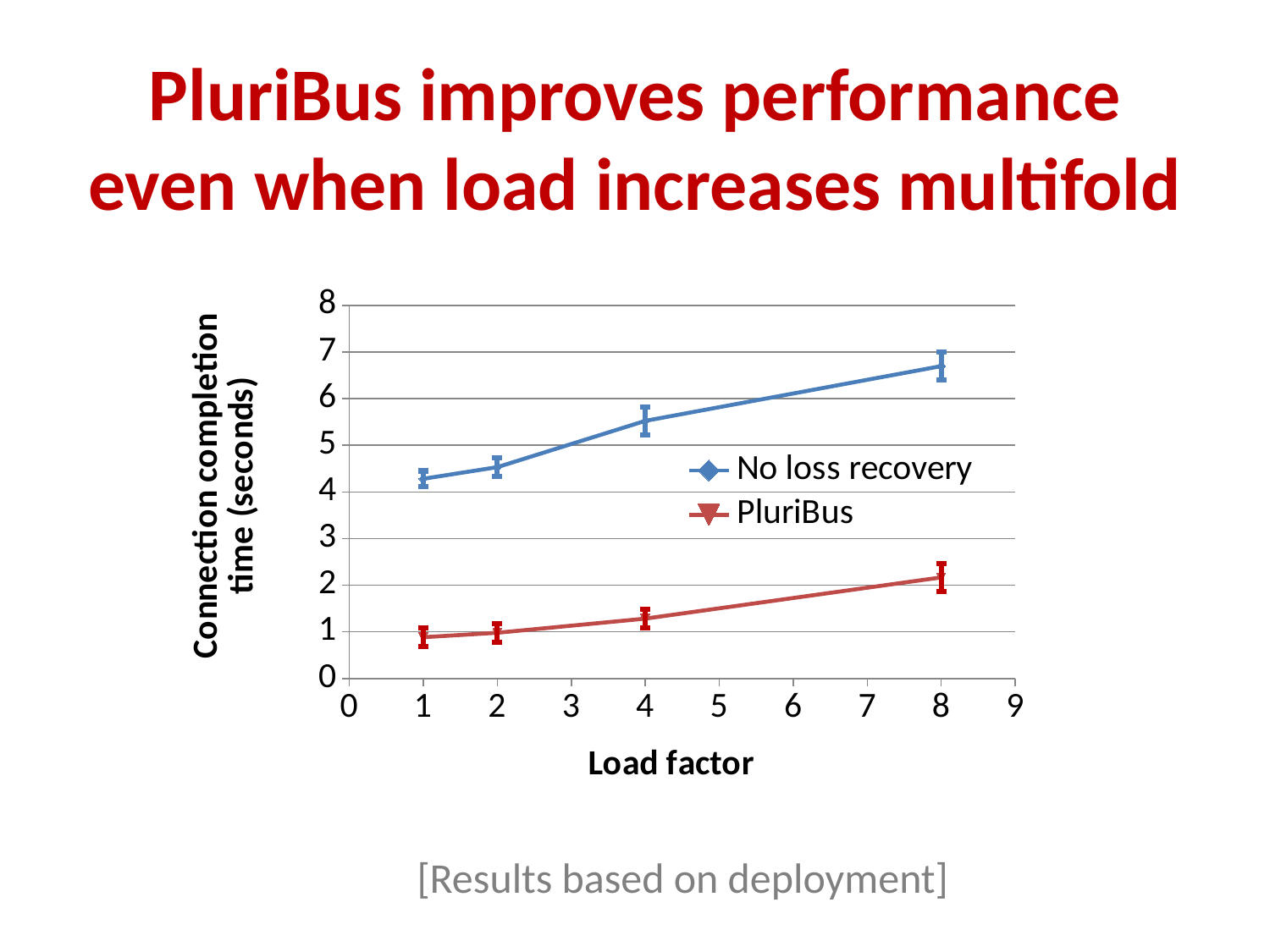
What is the title of the x axis? Load factor What kind of chart is shown on the slide? line chart How many data points are plotted for the PluriBus series? 4 Is the value for No loss recovery at load factor 1 greater or less than 5? less Is the value for PluriBus at load factor 4 greater or less than 2? less Is the value for No loss recovery at load factor 8 greater or less than 6? greater Does the connection completion time for PluriBus rise or fall as the load factor increases? rise What is the title of the y axis? Connection completion time (seconds) How many series does the legend list? 2 At load factor 8, which series has the higher connection completion time, No loss recovery or PluriBus? No loss recovery